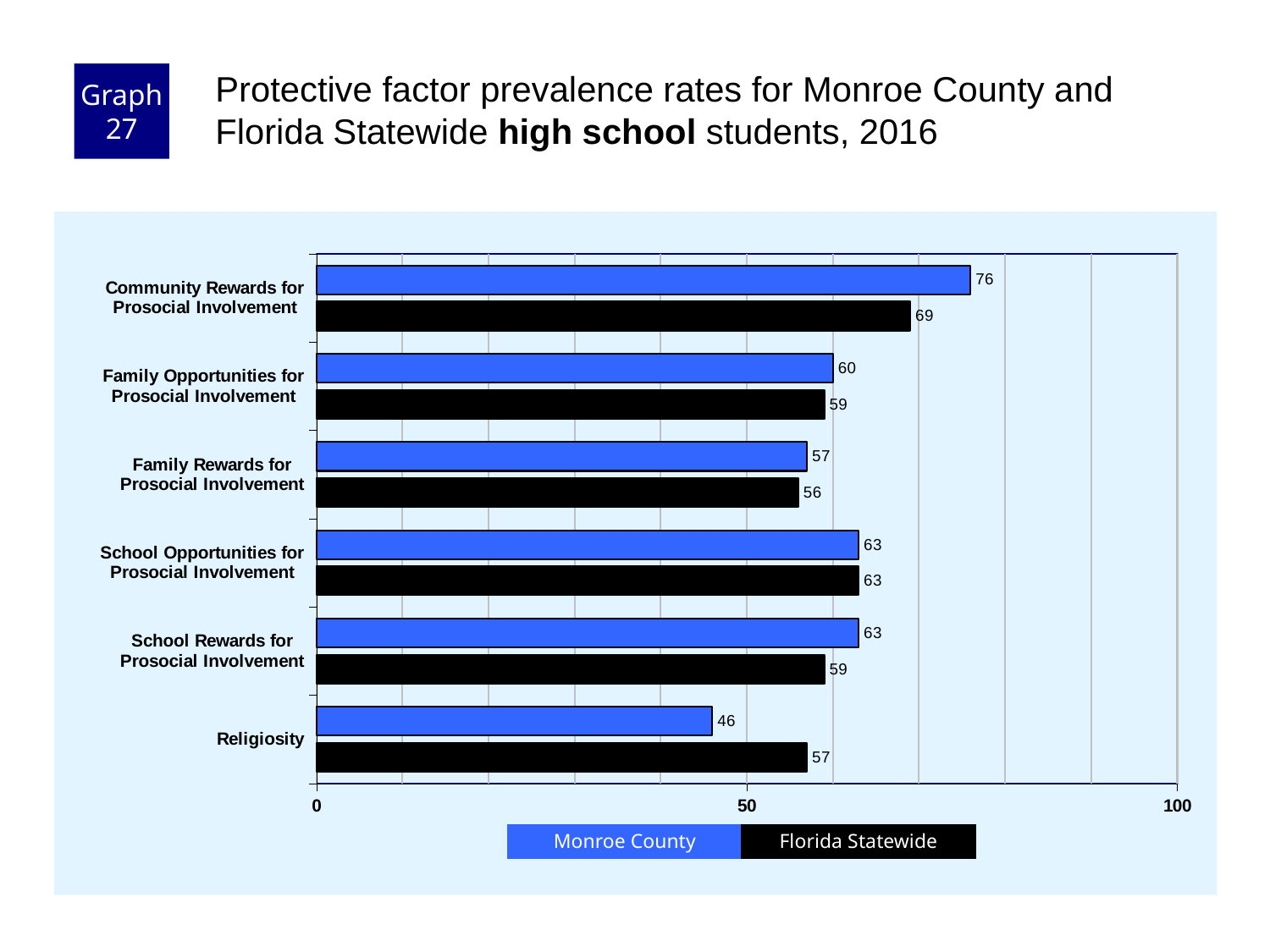
What kind of chart is shown on the slide? bar chart What is the difference between the Monroe County and Florida Statewide values for Community Rewards for Prosocial Involvement? 7 Which category has the highest Monroe County value? Community Rewards for Prosocial Involvement What is the Florida Statewide value for School Rewards for Prosocial Involvement? 59 What is the Monroe County value for Community Rewards for Prosocial Involvement? 76 Is the Monroe County value for Religiosity greater or less than 50? less How many series does the legend list? 2 Which category has the lowest Monroe County value? Religiosity What is the Florida Statewide value for Religiosity? 57 For Religiosity, which is larger: the Monroe County value or the Florida Statewide value? Florida Statewide What is the difference between the Florida Statewide and Monroe County values for Religiosity? 11 How many categories are shown on the chart? 6